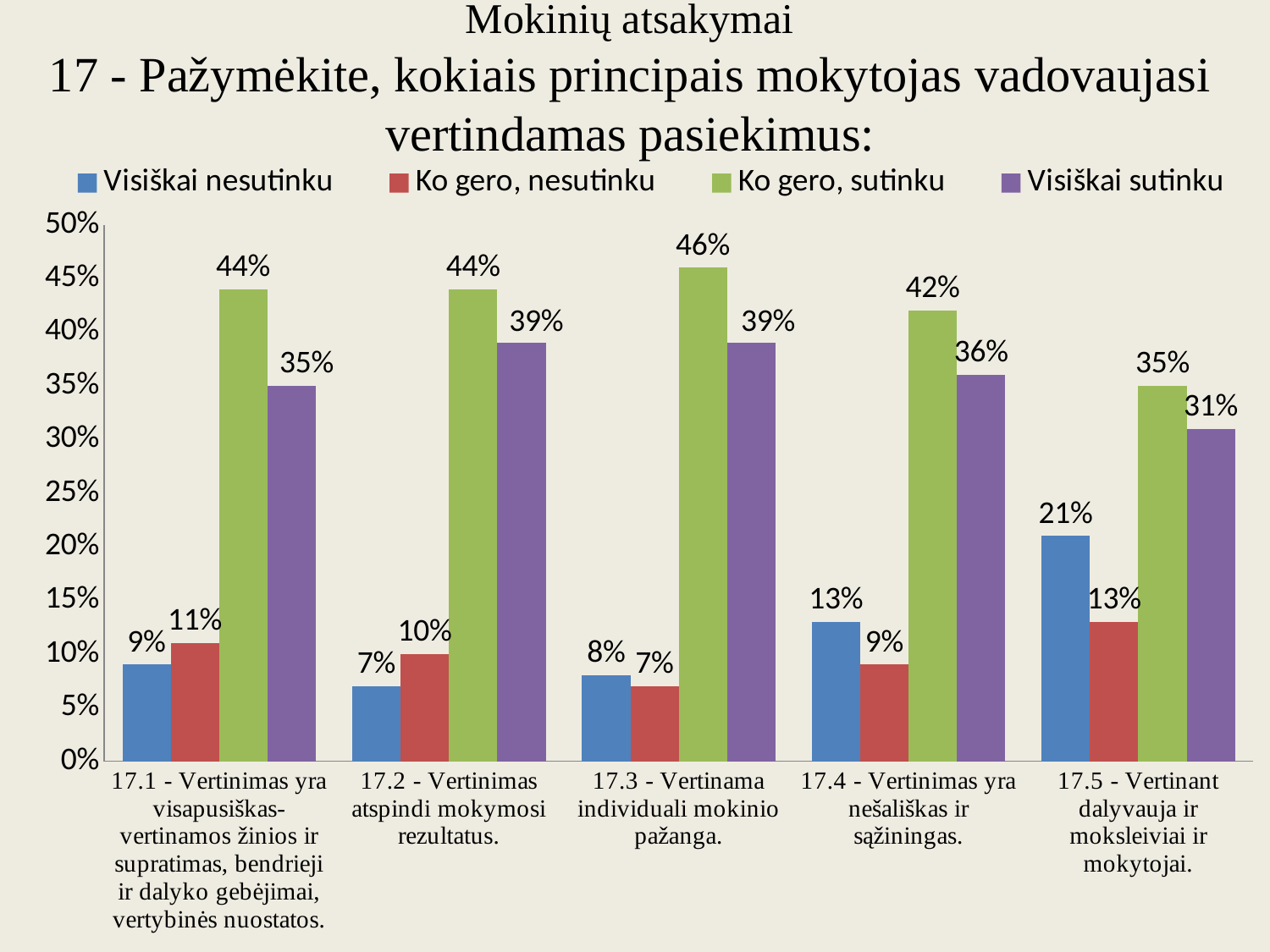
What kind of chart is shown on the slide? bar chart What is the value of "Visiškai nesutinku" for category 17.5 - Vertinant dalyvauja ir moksleiviai ir mokytojai? 21% How many categories are shown on the x axis? 5 Which category has the lowest value for the "Visiškai sutinku" series? 17.5 - Vertinant dalyvauja ir moksleiviai ir mokytojai. Which category has the highest value for the "Ko gero, sutinku" series? 17.3 - Vertinama individuali mokinio pažanga. What is the value of "Visiškai sutinku" for category 17.4 - Vertinimas yra nešališkas ir sąžiningas? 36% What is the value of "Ko gero, sutinku" for category 17.3 - Vertinama individuali mokinio pažanga? 46% Is the value of "Ko gero, sutinku" for category 17.4 greater or less than 40%? greater Which colour represents the "Ko gero, nesutinku" series in the legend? red For category 17.2 - Vertinimas atspindi mokymosi rezultatus, which is larger: "Visiškai nesutinku" or "Ko gero, nesutinku"? Ko gero, nesutinku What is the difference between "Ko gero, sutinku" and "Visiškai sutinku" for category 17.1? 9% How many series does the legend list? 4